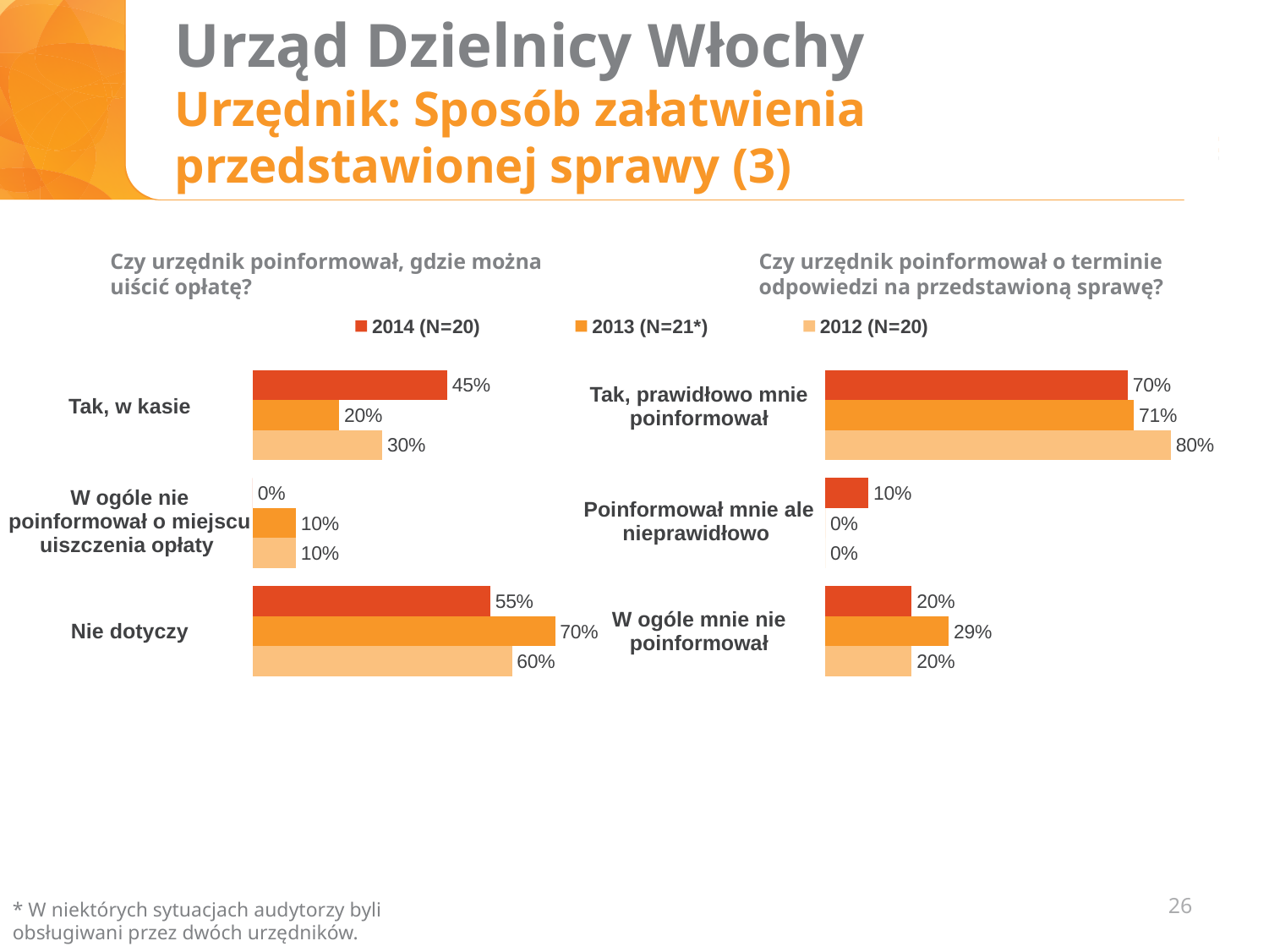
In the left chart (Czy urzędnik poinformował, gdzie można uiścić opłatę?), what is the value for 'Nie dotyczy' in 2013 (N=21*)? 70% In the left chart (Czy urzędnik poinformował, gdzie można uiścić opłatę?), which category has the highest value for 2014 (N=20)? Nie dotyczy In the left chart (Czy urzędnik poinformował, gdzie można uiścić opłatę?), what is the difference between the 2014 and 2013 values for 'Tak, w kasie'? 25 percentage points In the right chart (Czy urzędnik poinformował o terminie odpowiedzi na przedstawioną sprawę?), what is the value for 'Tak, prawidłowo mnie poinformował' in 2012 (N=20)? 80% In the right chart (Czy urzędnik poinformował o terminie odpowiedzi na przedstawioną sprawę?), what is the difference between the 2012 and 2014 values for 'Tak, prawidłowo mnie poinformował'? 10 percentage points How many series does the legend list? 3 In the right chart (Czy urzędnik poinformował o terminie odpowiedzi na przedstawioną sprawę?), what is the value for 'W ogóle mnie nie poinformował' in 2013 (N=21*)? 29% In the right chart (Czy urzędnik poinformował o terminie odpowiedzi na przedstawioną sprawę?), which category has the lowest value for 2014 (N=20)? Poinformował mnie ale nieprawidłowo How many categories does the right chart (Czy urzędnik poinformował o terminie odpowiedzi na przedstawioną sprawę?) show? 3 In the left chart (Czy urzędnik poinformował, gdzie można uiścić opłatę?), what is the value for 'Tak, w kasie' in 2014 (N=20)? 45% What type of chart is the left chart (Czy urzędnik poinformował, gdzie można uiścić opłatę?)? Bar chart In the left chart (Czy urzędnik poinformował, gdzie można uiścić opłatę?), which is larger for 'Nie dotyczy': the 2012 value or the 2014 value? 2012 (60%)